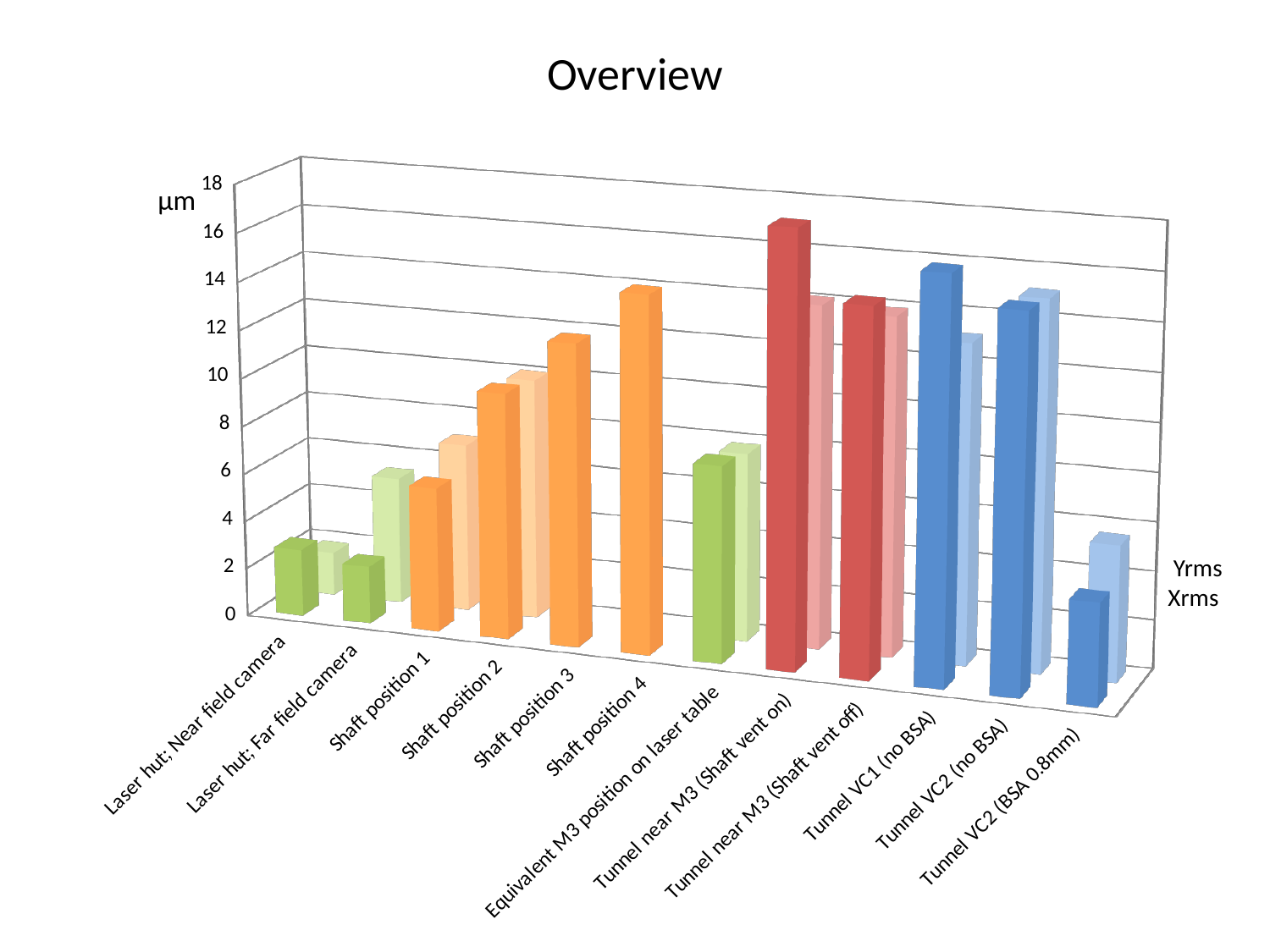
What type of chart is shown on the slide? bar chart Do the Xrms values rise or fall from Shaft position 1 to Shaft position 4? rise How many categories are plotted along the x axis? 12 Is the Xrms value for Tunnel near M3 (Shaft vent on) greater or less than 10? greater What is the title of the chart? Overview What unit is shown on the vertical axis? μm Is the Xrms value for Laser hut; Near field camera greater or less than 6? less How many series does the chart show? 2 Is the Xrms value for Tunnel VC2 (BSA 0.8mm) greater or less than 8? less Which category has the highest Xrms value? Tunnel near M3 (Shaft vent on) Which has the larger Xrms value, Tunnel VC1 (no BSA) or Tunnel VC2 (BSA 0.8mm)? Tunnel VC1 (no BSA)